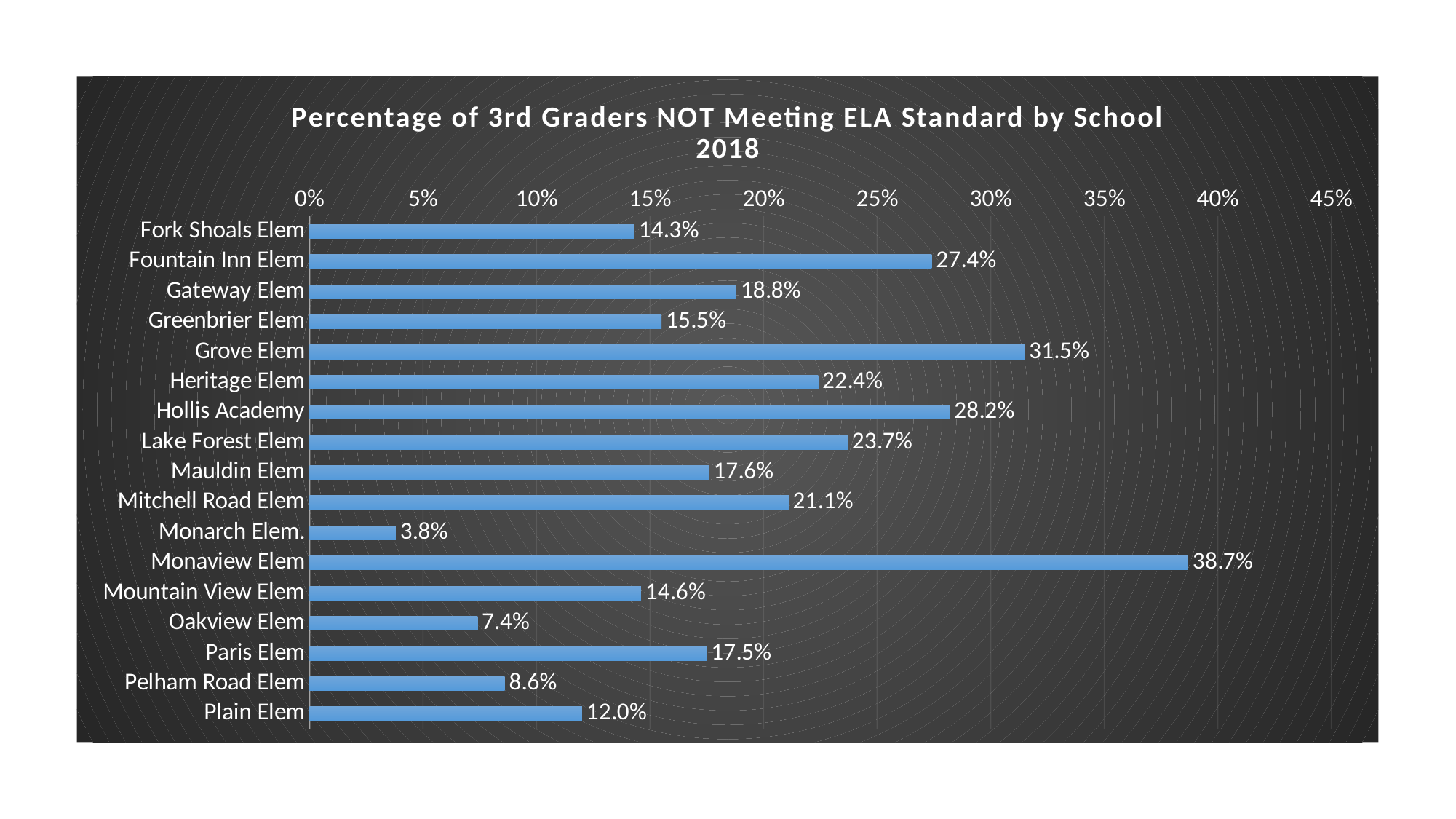
What is the difference between the values for Monaview Elem and Monarch Elem.? 34.9% Which school has the lowest percentage of 3rd graders not meeting the ELA standard? Monarch Elem. What is the difference between the values for Fountain Inn Elem and Fork Shoals Elem? 13.1% What is the value for Grove Elem? 31.5% Which is larger, the value for Heritage Elem or the value for Lake Forest Elem? Lake Forest Elem What is the title of the chart? Percentage of 3rd Graders NOT Meeting ELA Standard by School 2018 What is the value for Hollis Academy? 28.2% How many schools are shown in the chart? 17 What is the value for Pelham Road Elem? 8.6% What kind of chart is shown on the slide? bar chart Is the value for Mitchell Road Elem greater or less than 20%? greater Which school has the highest percentage of 3rd graders not meeting the ELA standard? Monaview Elem